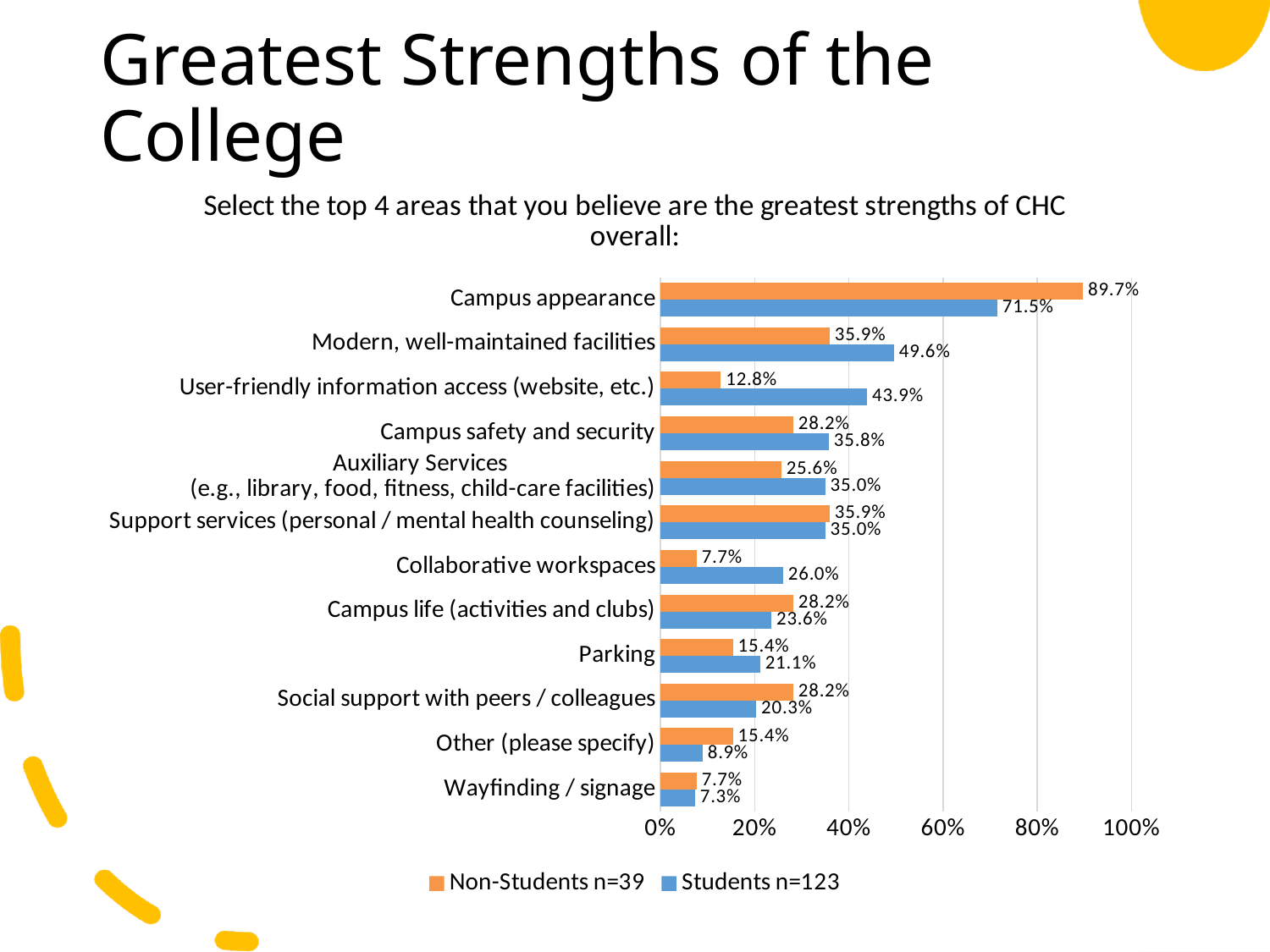
Is the Students value for User-friendly information access (website, etc.) greater or less than 40%? greater What is the Students value for Collaborative workspaces? 26.0% Which category has the highest value for Non-Students? Campus appearance What percentage of Students selected Campus appearance as a greatest strength? 71.5% What type of chart is shown on the slide? Bar chart How many categories are shown on the chart? 12 What is the difference between the Non-Students and Students values for Campus appearance? 18.2% How many series does the legend list? 2 For Modern, well-maintained facilities, which group has the larger value: Non-Students or Students? Students What percentage of Non-Students selected User-friendly information access (website, etc.)? 12.8% Which colour represents the Students n=123 series? Blue Which category has the lowest value for Students? Wayfinding / signage